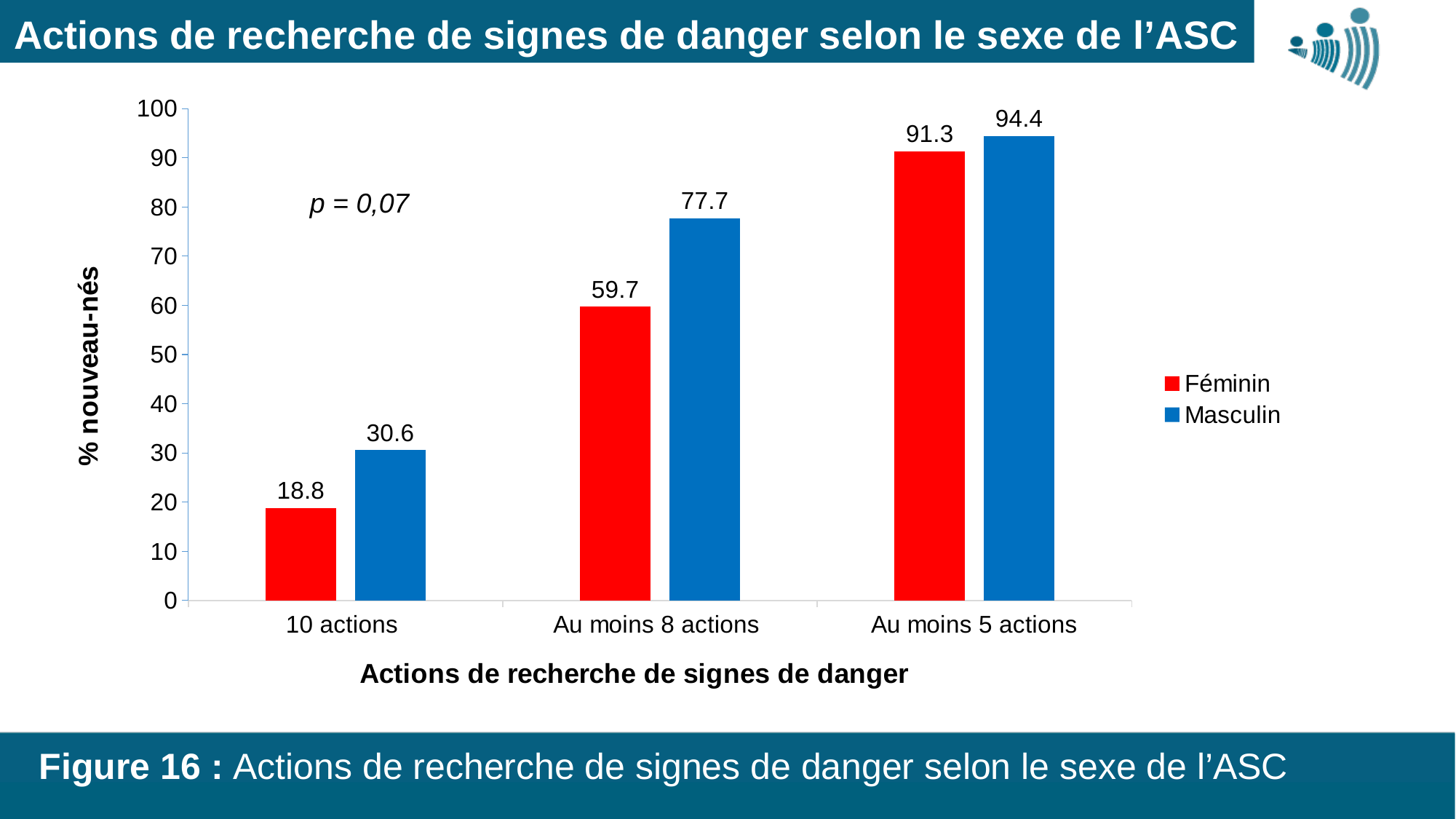
Which category has the highest value for Masculin? Au moins 5 actions What is the value for Féminin in the 'Au moins 5 actions' category? 91.3 How many series does the legend list? 2 What is the p-value annotation shown on the chart? p = 0,07 What is the difference between the Masculin and Féminin values in the '10 actions' category? 11.8 What is the value for Masculin in the 'Au moins 8 actions' category? 77.7 What is the difference between the Masculin and Féminin values in the 'Au moins 8 actions' category? 18 What kind of chart is shown on the slide? Bar chart How many categories are shown on the x axis? 3 In the 'Au moins 5 actions' category, which series has the larger value, Féminin or Masculin? Masculin Which category has the lowest value for Féminin? 10 actions What is the value for Féminin in the '10 actions' category? 18.8